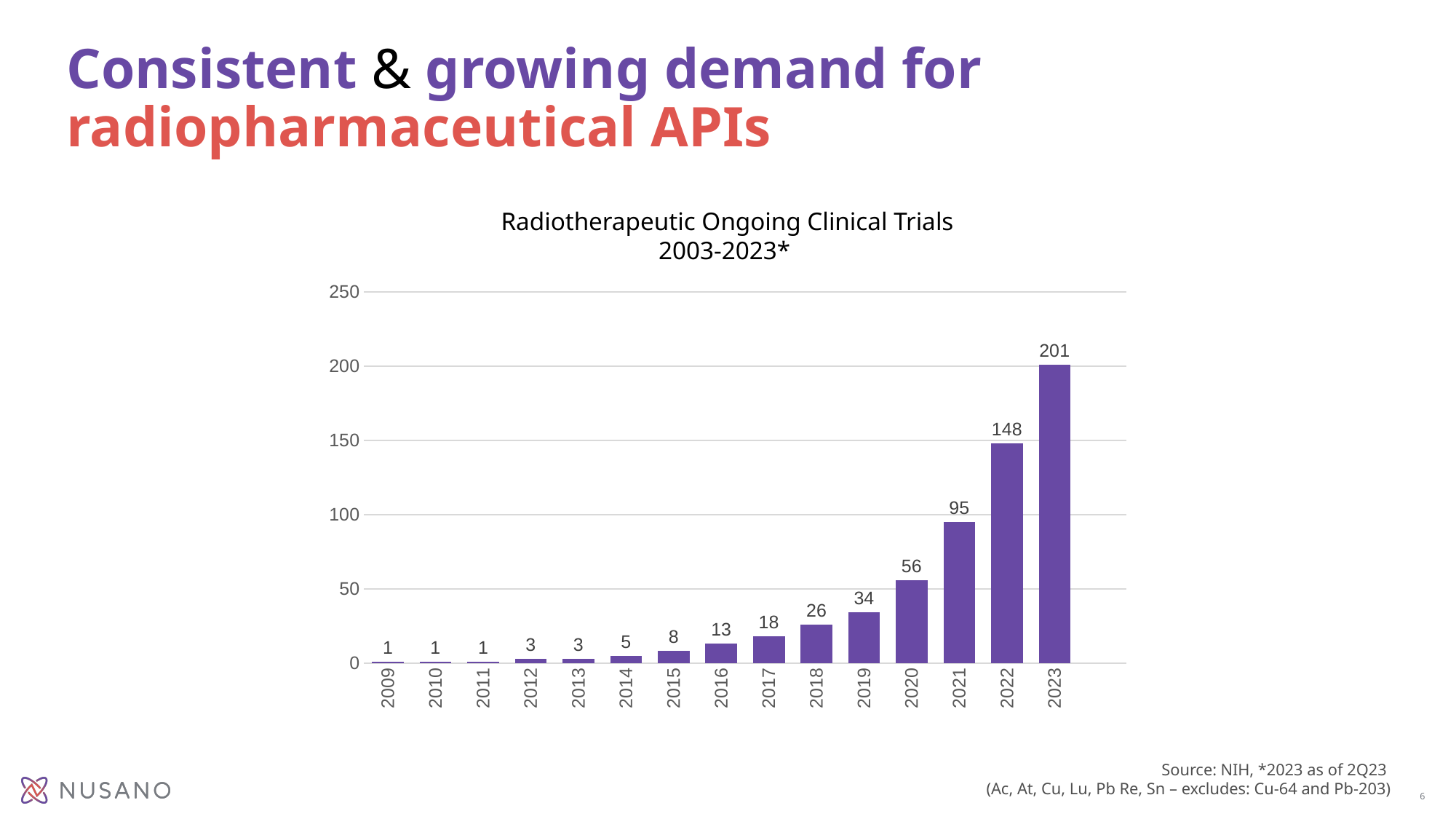
What is the value for 2023? 201 Which is larger, the value for 2018 or the value for 2017? 2018 What is the difference between the values for 2021 and 2020? 39 What is the difference between the values for 2023 and 2022? 53 Is the value for 2022 greater or less than 100? greater Which year has the highest value? 2023 What kind of chart is shown? bar chart Do the values rise or fall from 2009 to 2023? rise What is the value for 2015? 8 What is the title of the chart? Radiotherapeutic Ongoing Clinical Trials 2003-2023* How many years are shown on the x axis? 15 What is the value for 2019? 34